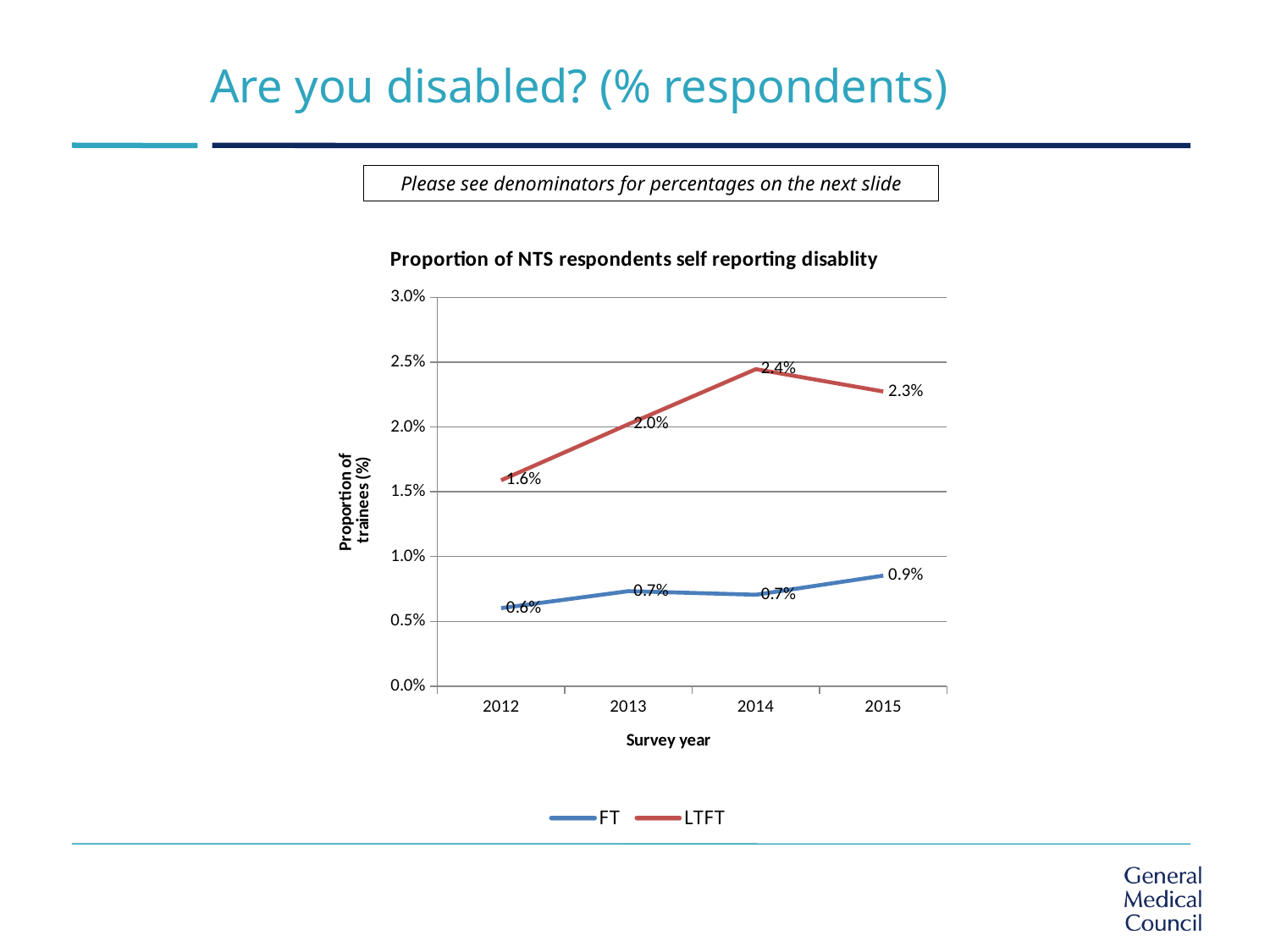
What is the title of the chart? Proportion of NTS respondents self reporting disablity What is the FT value for 2012? 0.6% What is the difference between the LTFT and FT values in 2013? 1.3% What is the LTFT value for 2014? 2.4% In which survey year is the LTFT value highest? 2014 What is the LTFT value for 2015? 2.3% Which series has the larger value in 2015, FT or LTFT? LTFT How many survey years are shown on the x axis? 4 In which survey year is the FT value lowest? 2012 What is the FT value for 2015? 0.9% How many series does the legend list? 2 What type of chart is shown on the slide? line chart